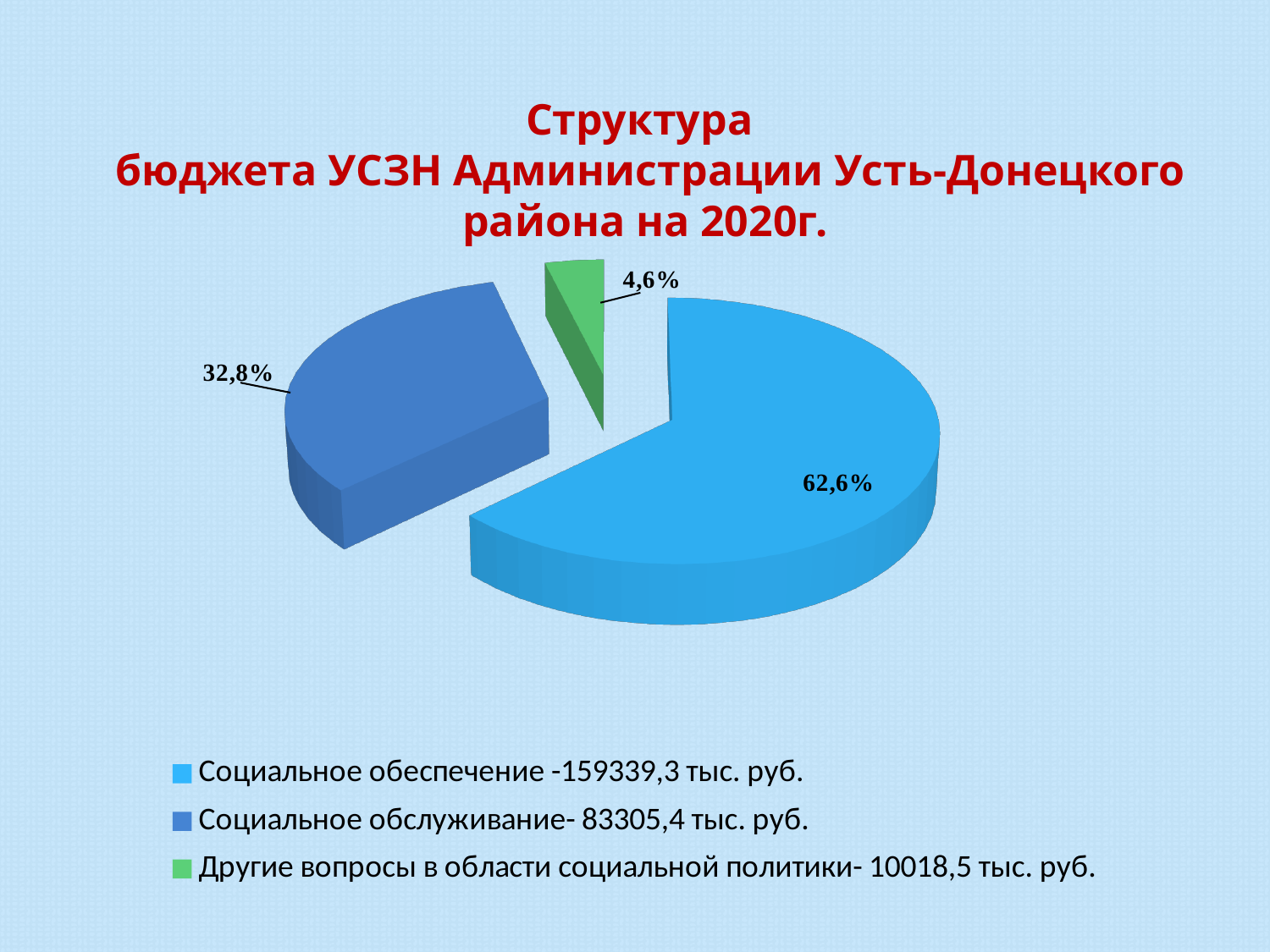
What kind of chart is shown on the slide? Pie chart What share of the pie does "Социальное обеспечение" take? 62,6% How many slices does the pie chart have? 3 Which category has the smallest slice of the pie? Другие вопросы в области социальной политики What is the difference in percentage points between the "Социальное обеспечение" slice and the "Социальное обслуживание" slice? 29,8 Which category has the largest slice of the pie? Социальное обеспечение According to the legend, what amount in тыс. руб. corresponds to "Другие вопросы в области социальной политики"? 10018,5 тыс. руб. What share of the pie does "Социальное обслуживание" take? 32,8% What colour is the slice for "Другие вопросы в области социальной политики"? Green According to the legend, what amount in тыс. руб. corresponds to "Социальное обслуживание"? 83305,4 тыс. руб. Which is larger: the "Социальное обслуживание" slice or the "Другие вопросы в области социальной политики" slice? Социальное обслуживание What share of the pie does "Другие вопросы в области социальной политики" take? 4,6%